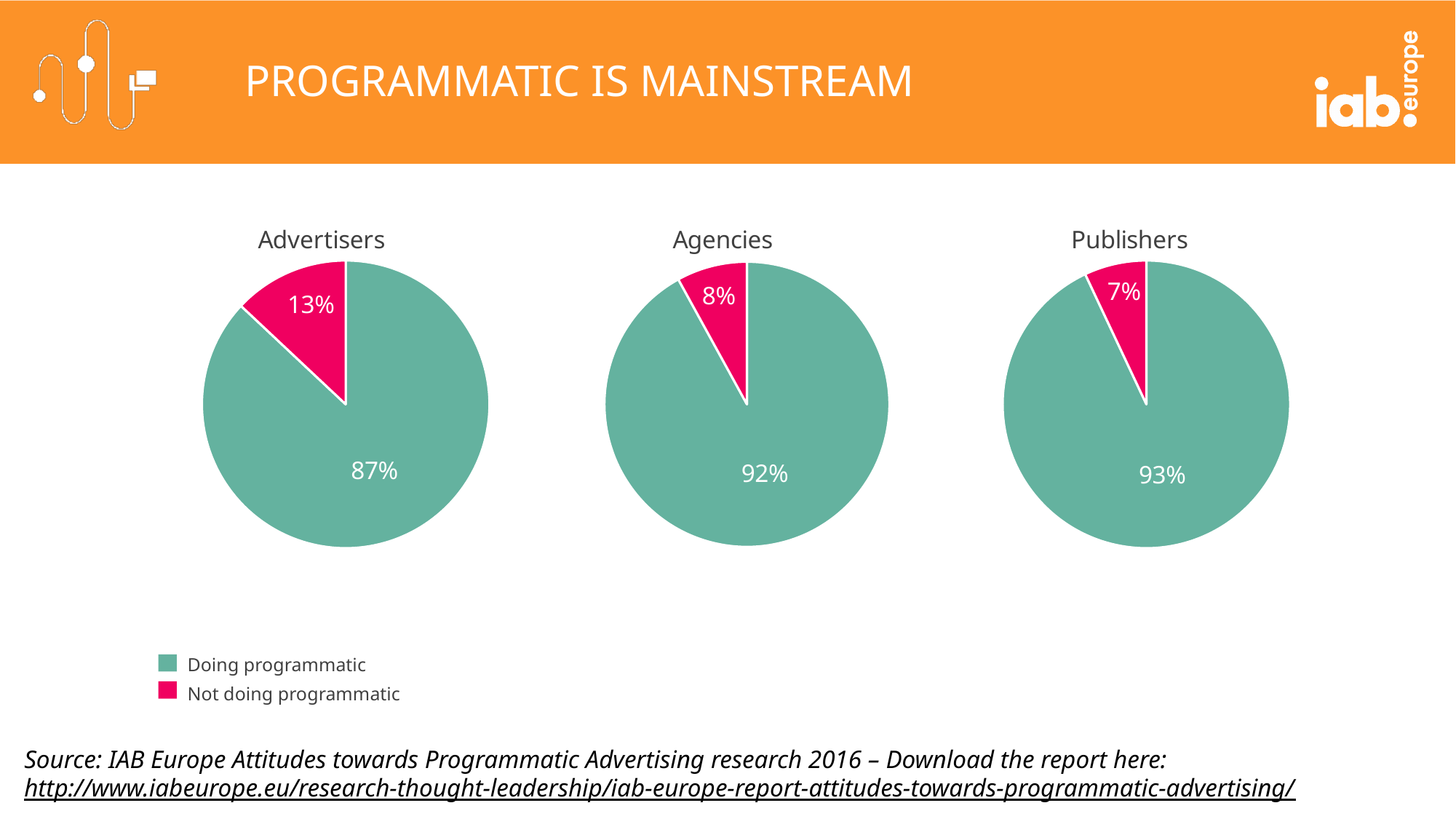
In the Publishers pie chart, what share is doing programmatic? 93% In the Agencies pie chart, what share is doing programmatic? 92% Across the three pie charts, which group has the lowest share doing programmatic? Advertisers In the Publishers pie chart, what share is not doing programmatic? 7% In the Advertisers pie chart, what share is doing programmatic? 87% In the Advertisers pie chart, what share is not doing programmatic? 13% In the Agencies pie chart, what share is not doing programmatic? 8% Across the three pie charts, which group has the highest share doing programmatic? Publishers How many entries does the legend list? 2 Which is larger: the share doing programmatic for Agencies or for Advertisers? Agencies What is the difference between the share not doing programmatic for Advertisers and for Publishers? 6% What kind of chart is used for the Advertisers, Agencies and Publishers data? Pie chart